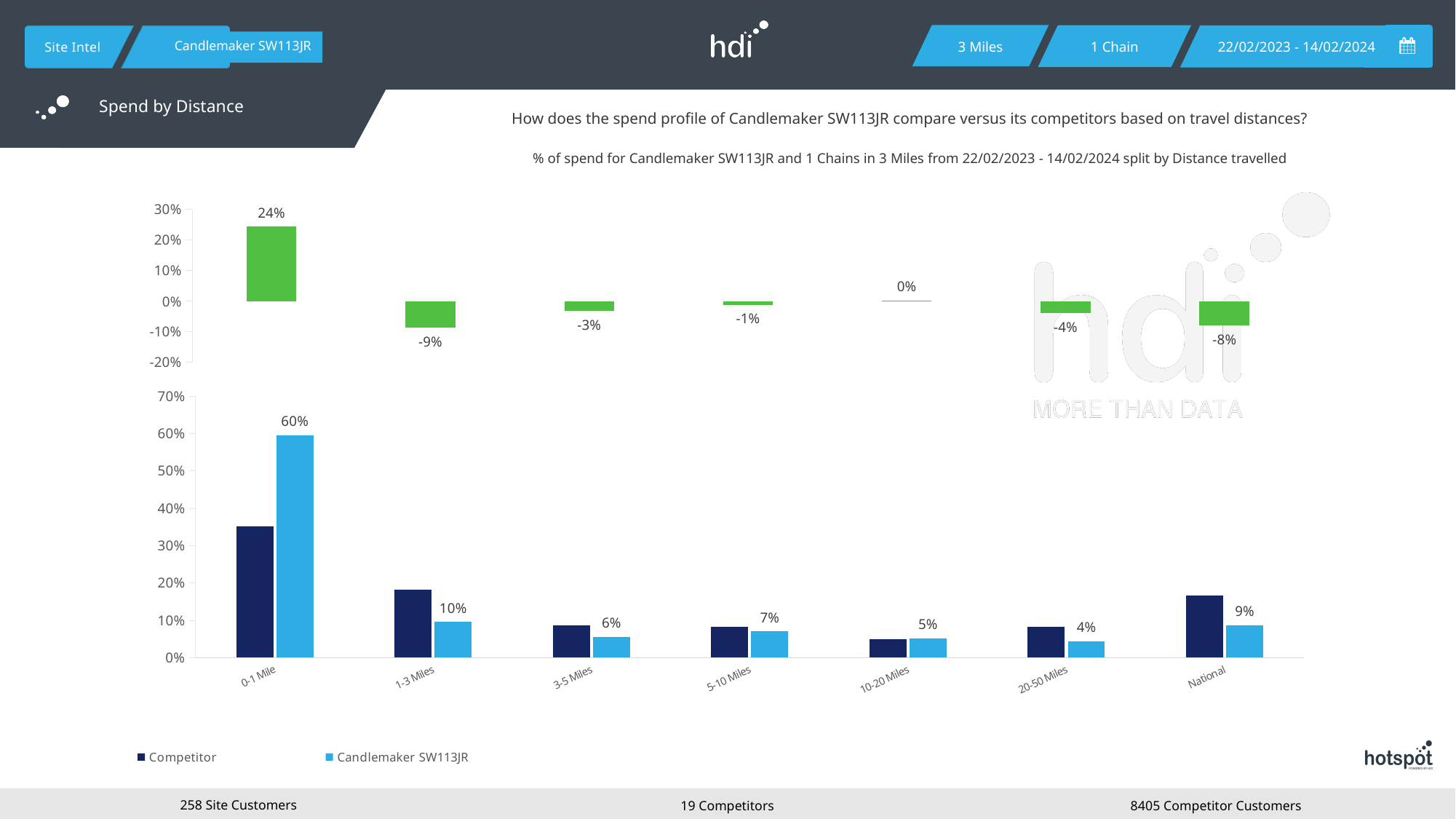
In the top chart, what is the value shown for 10-20 Miles? 0% In the top chart, which distance category has the lowest value? 1-3 Miles In the top chart, what is the value shown for 1-3 Miles? -9% In the bottom chart, is the Competitor value for National greater or less than 10%? greater In the bottom chart, is the Competitor value for 0-1 Mile greater or less than 30%? greater How many series does the legend of the bottom chart list? 2 In the bottom chart, what is the difference between the Candlemaker SW113JR values for 0-1 Mile and 1-3 Miles? 50 percentage points In the bottom chart, which is larger for 1-3 Miles: Competitor or Candlemaker SW113JR? Competitor In the bottom chart, which distance category has the lowest value for Candlemaker SW113JR? 20-50 Miles How many distance categories are shown on the x axis of the bottom chart? 7 In the top chart, which distance category has the highest value? 0-1 Mile In the bottom chart, what is the value for Candlemaker SW113JR in the 0-1 Mile category? 60%